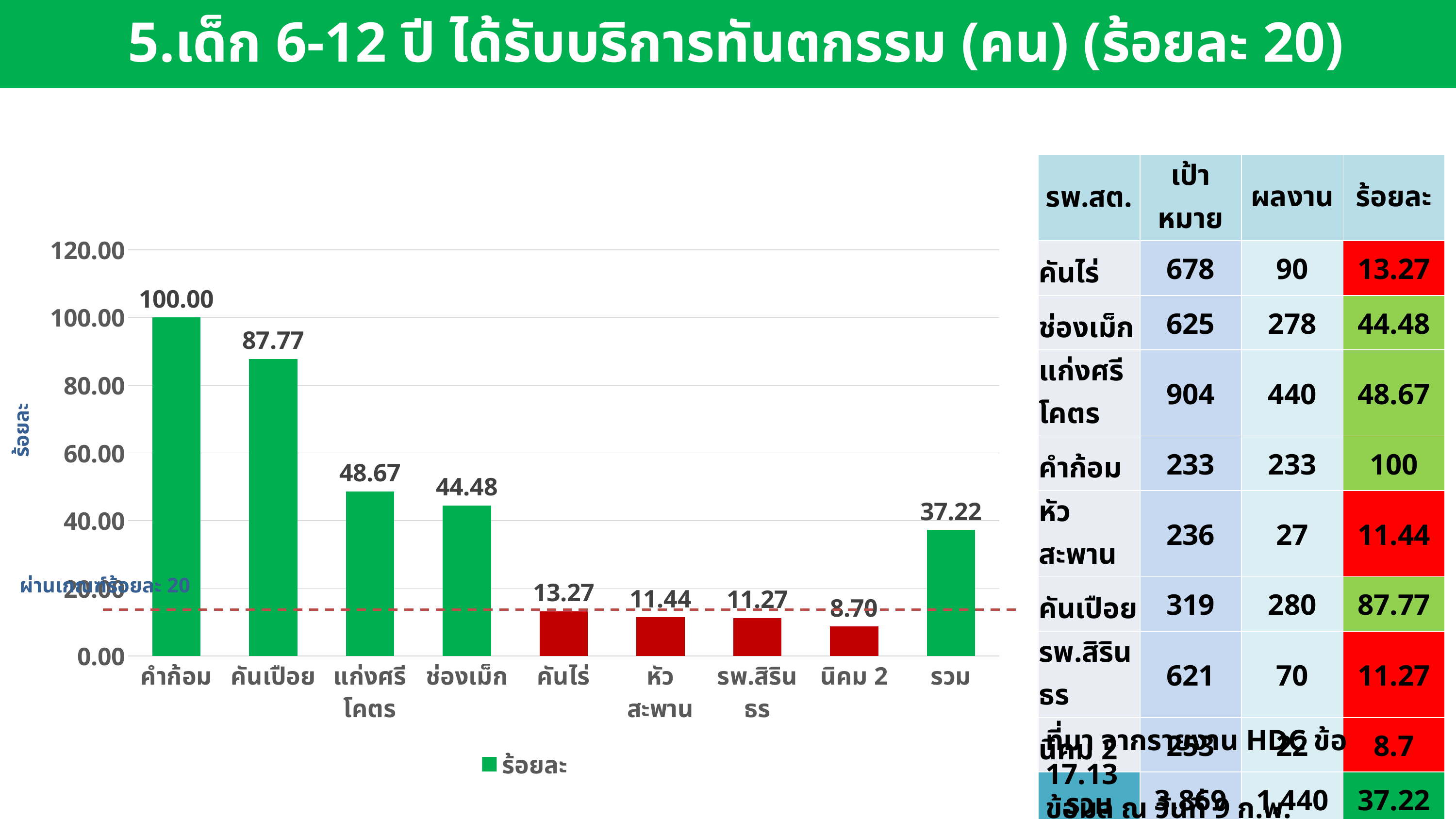
What is the difference between the values for แก่งศรีโคตร and ช่องเม็ก? 4.19 What is the value for รวม in the bar chart? 37.22 What is the value for นิคม 2 in the bar chart? 8.70 What is the value for คำก้อม in the bar chart? 100.00 Which category has the lowest value in the bar chart? นิคม 2 Is the value for ช่องเม็ก greater or less than 40? greater What series name does the chart legend show? ร้อยละ What kind of chart is shown on the slide? bar chart Which is larger, the value for คันไร่ or the value for หัวสะพาน? คันไร่ What is the value for คันเปือย in the bar chart? 87.77 Which category has the highest value in the bar chart? คำก้อม How many categories are shown on the x axis of the bar chart? 9